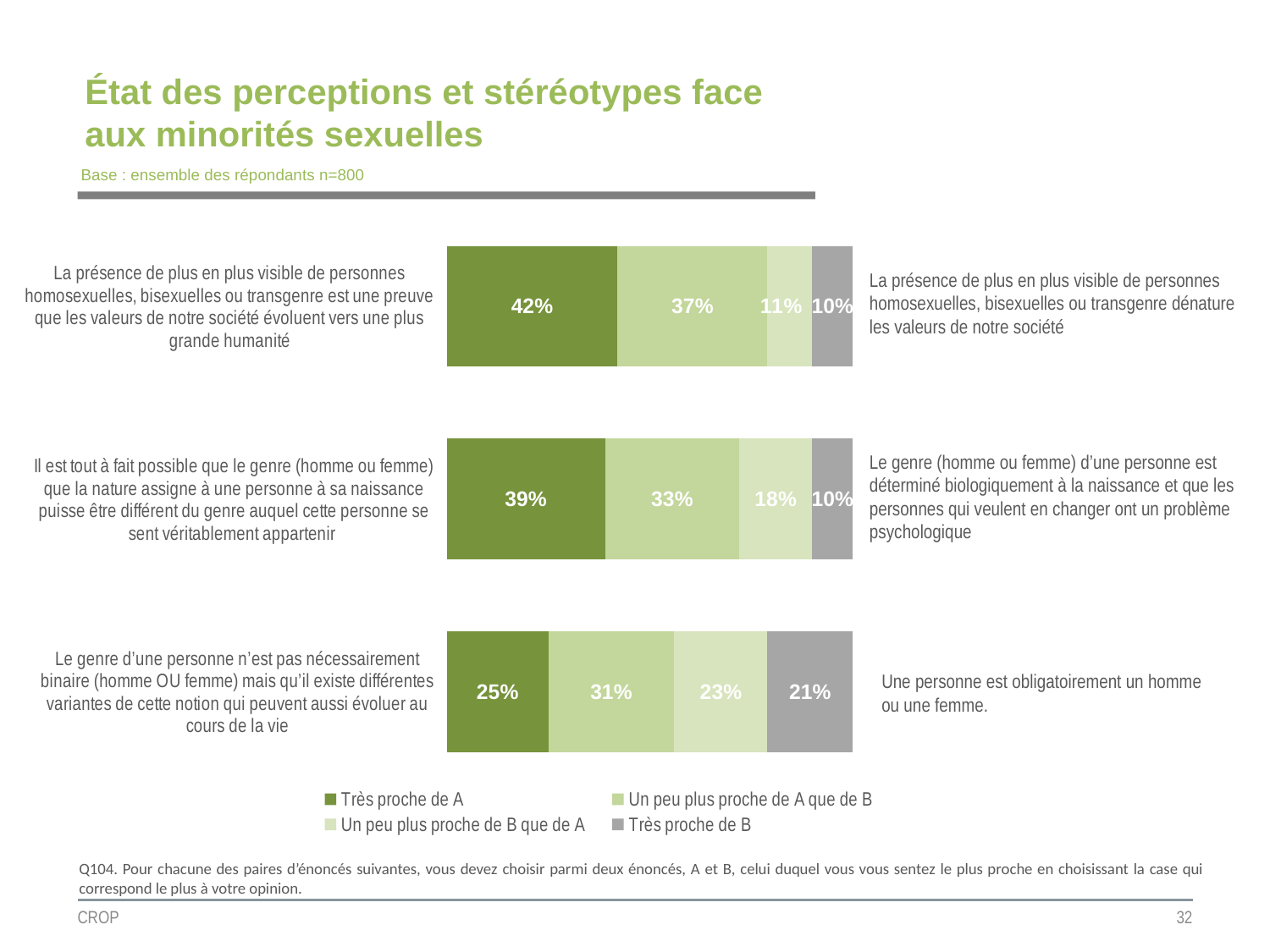
What kind of chart is shown on the slide? Stacked bar chart In the second bar (gender can differ from the one assigned at birth), which is larger: 'Un peu plus proche de B que de A' or 'Très proche de B'? Un peu plus proche de B que de A What is the total of the 'Un peu plus proche de B que de A' and 'Très proche de B' segments in the bottom bar (gender is not necessarily binary)? 44% Which legend entry is shown in the darkest green colour? Très proche de A How many series does the legend list? 4 What is the 'Très proche de A' value for the top bar (the statement about the increasingly visible presence of homosexual, bisexual or transgender people being proof that society's values are evolving)? 42% What is the 'Très proche de B' value for the bottom bar (the statement that gender is not necessarily binary)? 21% What is the difference between the 'Très proche de A' values of the top bar (42%) and the bottom bar (25%)? 17 percentage points Which bar has the highest 'Très proche de A' value? The top bar (La présence de plus en plus visible de personnes homosexuelles, bisexuelles ou transgenre est une preuve que les valeurs de notre société évoluent vers une plus grande humanité) How many bars (pairs of statements) are plotted in the chart? 3 Which bar has the lowest 'Très proche de A' value? The bottom bar (Le genre d'une personne n'est pas nécessairement binaire) What is the 'Un peu plus proche de A que de B' value for the second bar (the statement that a person's gender can differ from the one assigned at birth)? 33%